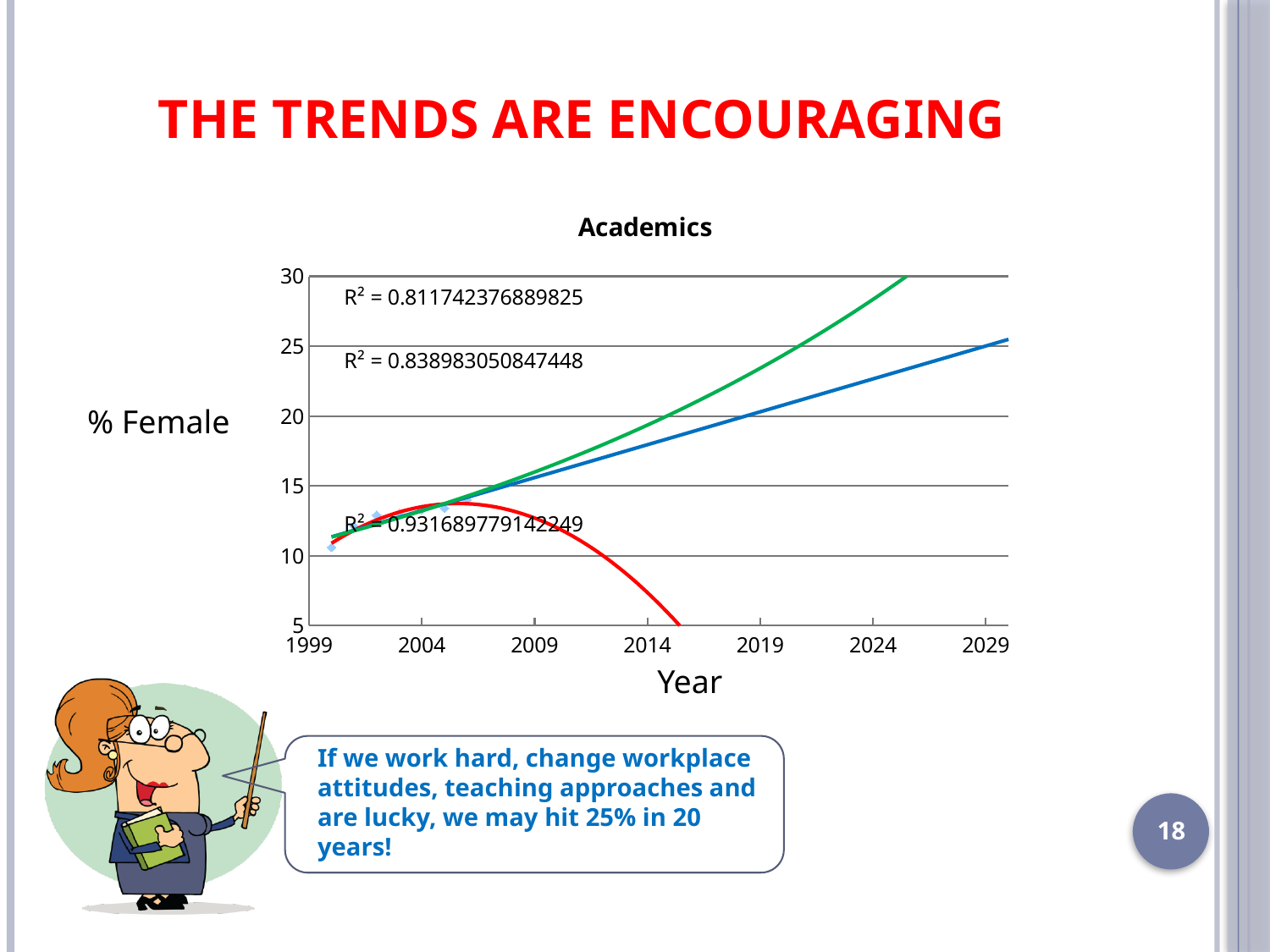
Which trendline, green or blue, is higher at 2024? green Which trendline reaches 30% Female first: the green or the blue one? green What is the title of the chart? Academics What is the second R² value printed on the chart, just below the first? 0.838983050847448 What label is shown on the vertical axis of the chart? % Female What is the R² value printed near the data points in the lower part of the chart? 0.931689779142249 Does the red trendline rise or fall after about 2009? fall Is the value of the green trendline at 2019 greater or less than 25? less Is the value of the blue trendline at 2029 greater or less than 20? greater Does the blue trendline rise or fall as the year increases? rise What is the R² value printed at the top of the chart? 0.811742376889825 What is the first year label shown on the x axis? 1999